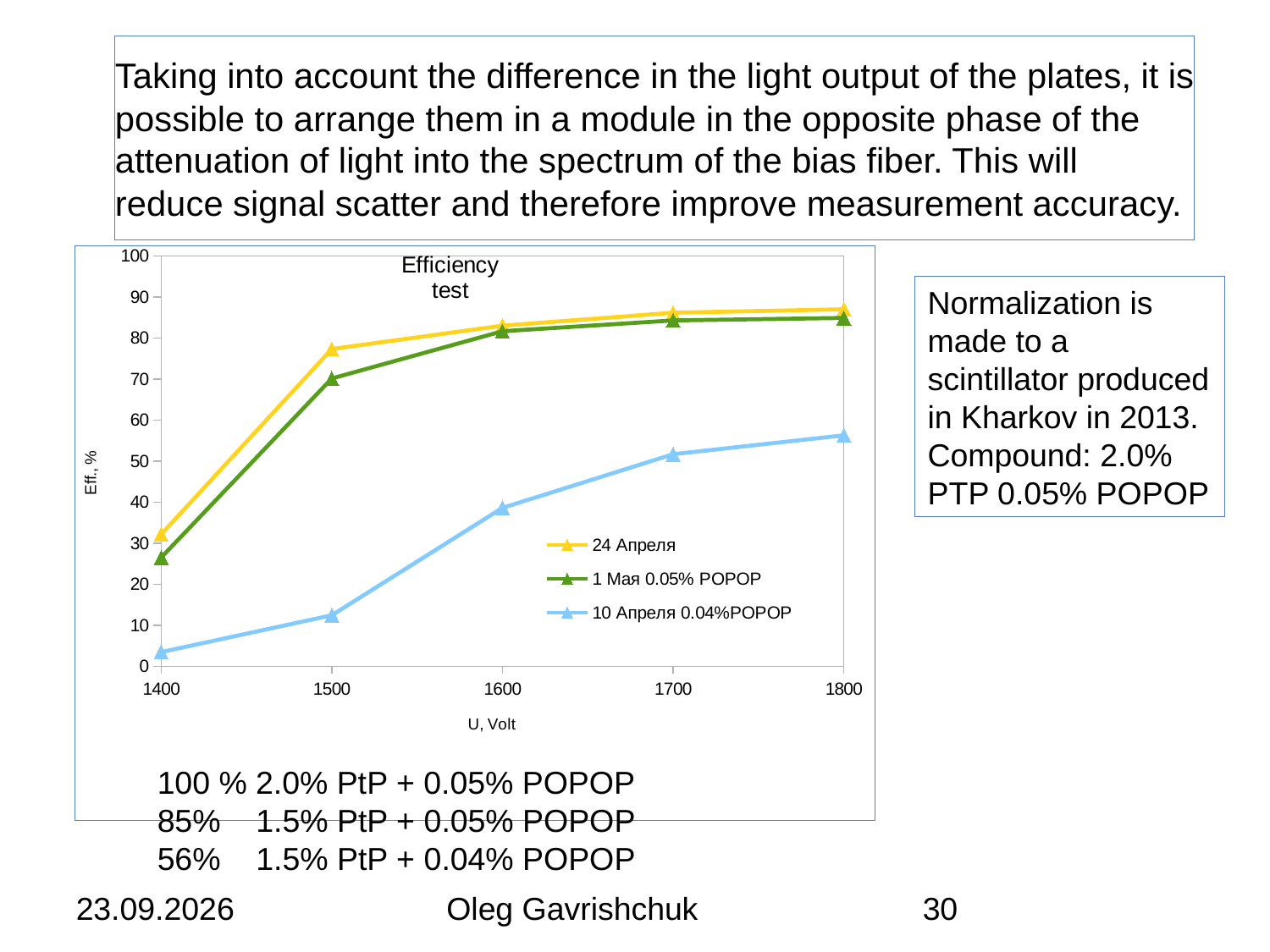
What is the label of the x axis? U, Volt Is the value for '10 Апреля 0.04%POPOP' at 1400 V greater or less than 10? less What is the title of the chart? Efficiency test Is the value for '1 Мая 0.05% POPOP' at 1500 V greater or less than 60? greater At 1500 V, which is larger: the value for '24 Апреля' or the value for '10 Апреля 0.04%POPOP'? 24 Апреля Is the value for '24 Апреля' at 1600 V greater or less than 80? greater Which series has the highest efficiency at 1500 V? 24 Апреля What kind of chart is shown on the slide? line chart Which series has the lowest efficiency at 1800 V? 10 Апреля 0.04%POPOP How many voltage points are plotted along the x axis for each series? 5 How many series does the legend list? 3 Does the efficiency for the series '10 Апреля 0.04%POPOP' rise or fall as the voltage increases from 1400 to 1800? rise